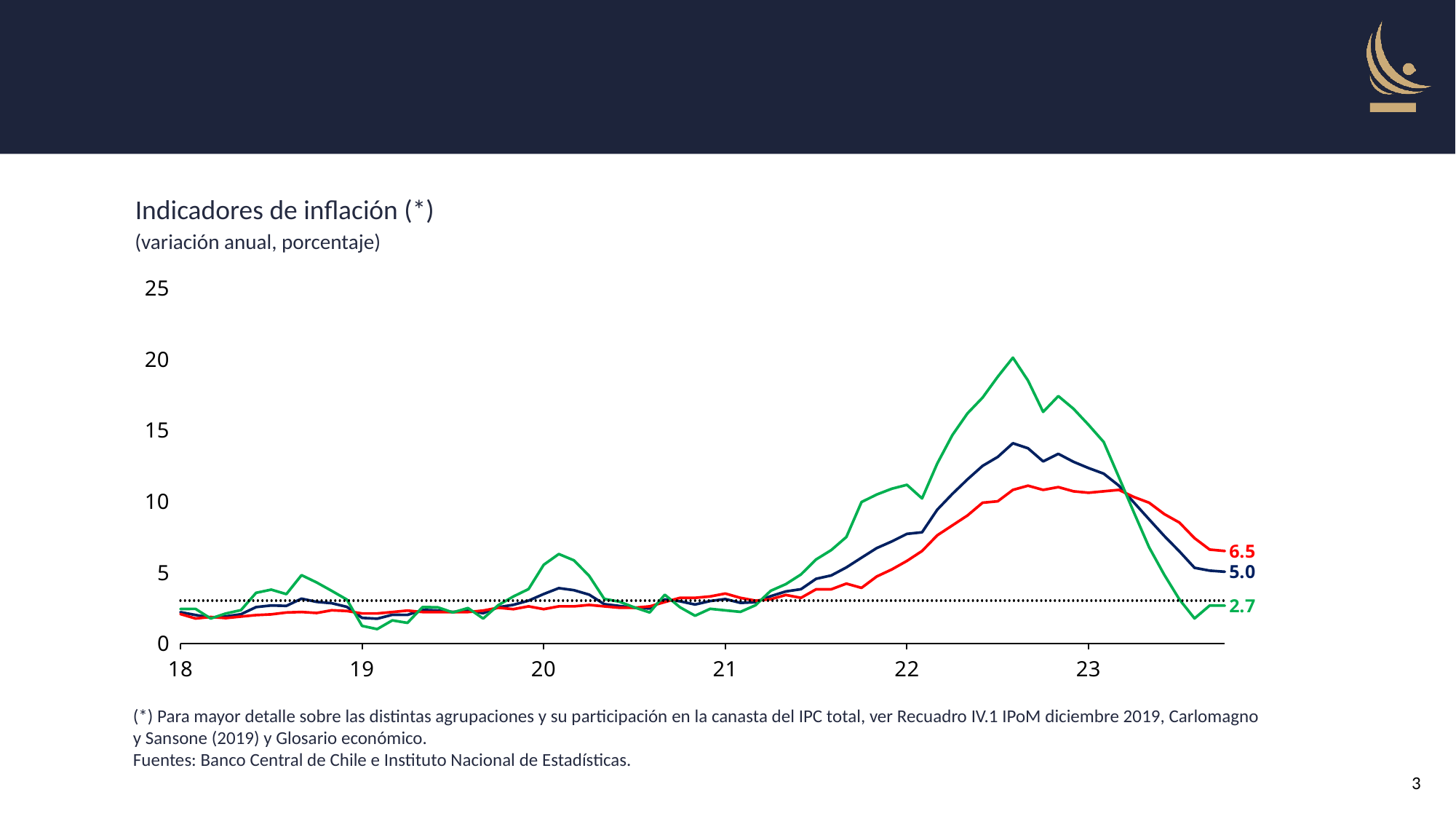
What is the final value labelled at the end of the green line? 2.7 Which line ends with the lowest labelled value: red, dark blue or green? green What unit does the chart's subtitle say the values are in? variación anual, porcentaje What is the title of the chart? Indicadores de inflación (*) What is the difference between the final labelled values of the red line and the green line? 3.8 Which line ends with the highest labelled value: red, dark blue or green? red What is the final value labelled at the end of the red line? 6.5 How many coloured lines are plotted on the chart? 3 What is the final value labelled at the end of the dark blue line? 5.0 Is the peak value of the red line greater or less than 15? less What kind of chart is shown on the slide? line chart Is the peak value of the green line greater or less than 15? greater